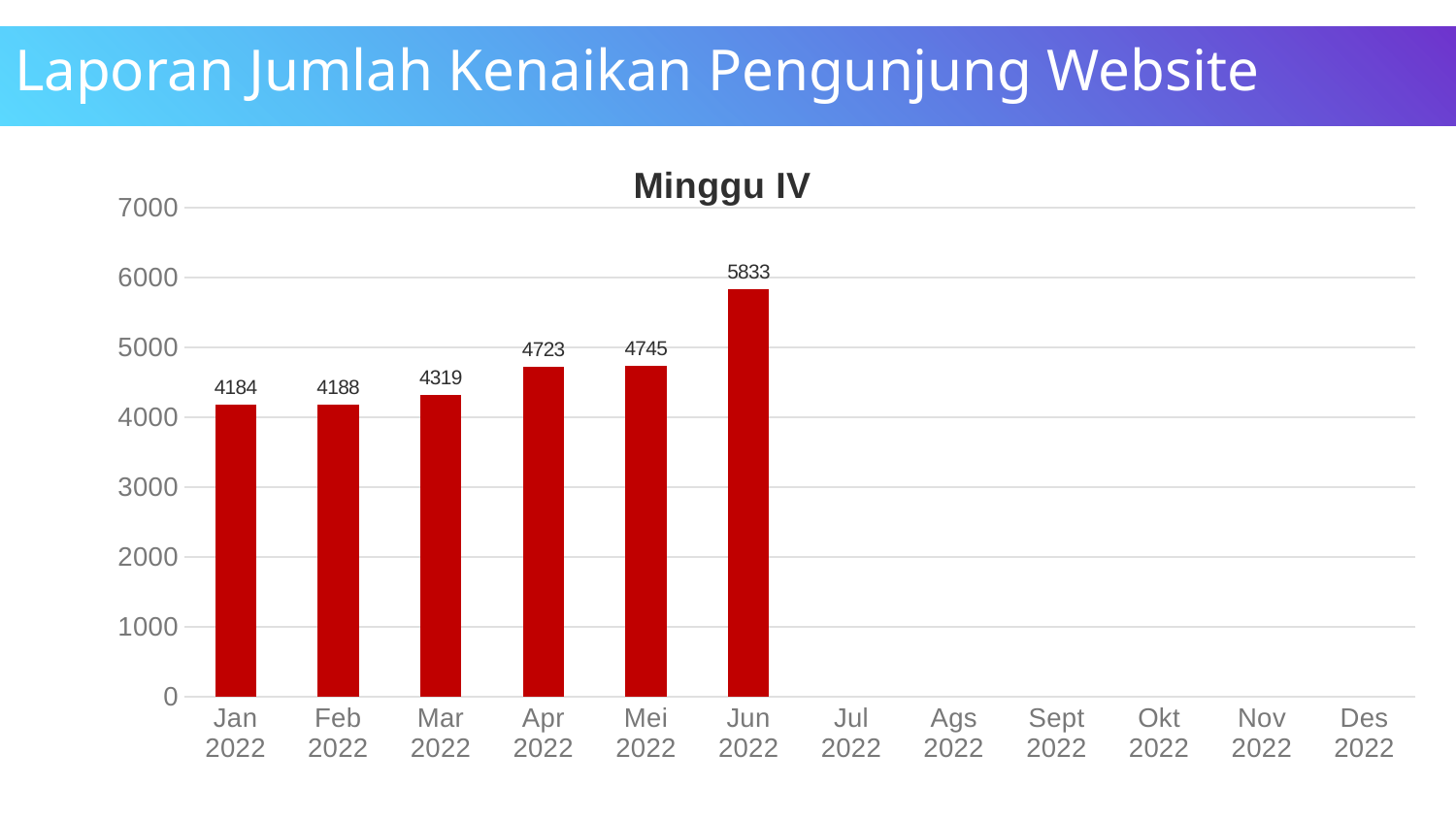
What is the value for Jun 2022? 5833 What kind of chart is shown on the slide? bar chart What is the value for Jan 2022? 4184 Do the values rise or fall from Jan 2022 to Jun 2022? rise Is the value for Jun 2022 greater or less than 5000? greater What is the value for Mar 2022? 4319 Which month has the highest value? Jun 2022 What is the difference between the values for Jun 2022 and Jan 2022? 1649 What is the difference between the values for Mar 2022 and Feb 2022? 131 How many months have a bar plotted on the chart? 6 Which is larger, the value for Apr 2022 or the value for Mar 2022? Apr 2022 Which month with a plotted bar has the lowest value? Jan 2022